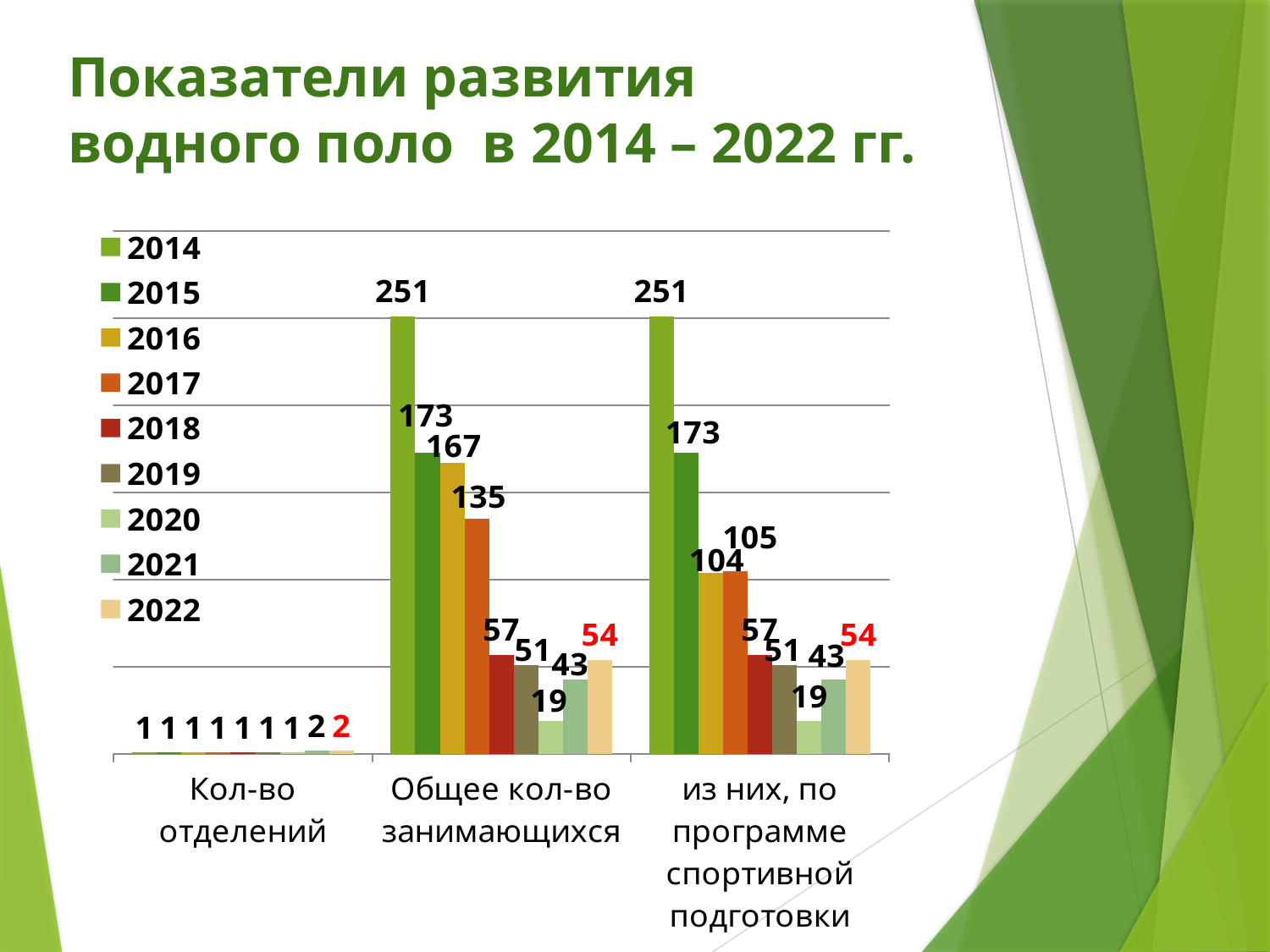
Which year has the lowest value in the category "из них, по программе спортивной подготовки"? 2020 What is the value for 2016 in the category "из них, по программе спортивной подготовки"? 104 What kind of chart is shown on the slide? bar chart How many categories are shown on the x axis? 3 What is the difference between the 2016 and 2017 values in the category "Общее кол-во занимающихся"? 32 In the category "Общее кол-во занимающихся", which is larger: the value for 2021 or the value for 2022? 2022 What is the value for 2022 in the category "Кол-во отделений"? 2 How many series does the legend list? 9 Which year has the highest value in the category "Общее кол-во занимающихся"? 2014 What is the value for 2014 in the category "Общее кол-во занимающихся"? 251 What is the value for 2020 in the category "Общее кол-во занимающихся"? 19